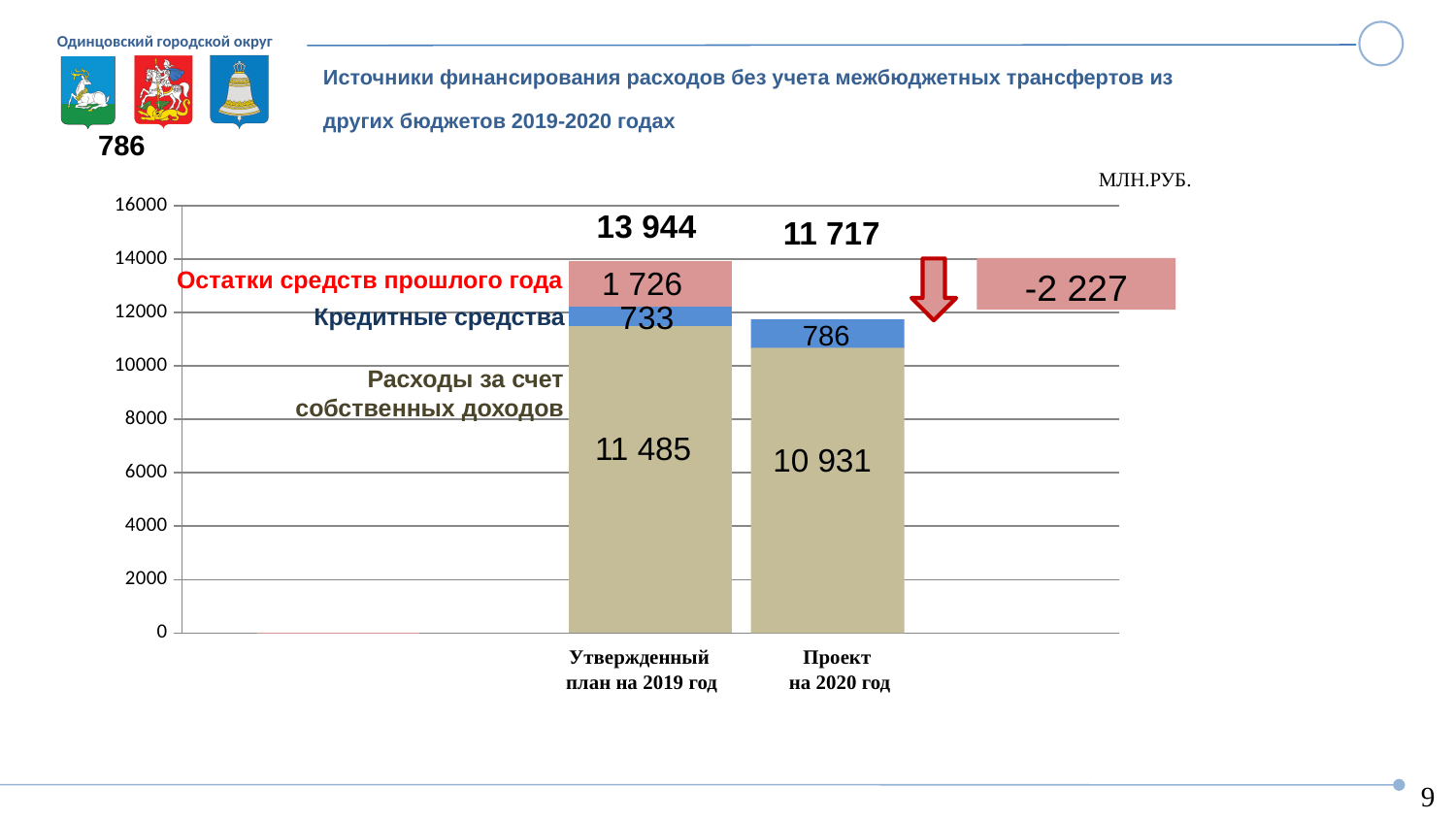
What is the difference between the totals for 'Проект на 2020 год' and 'Утвержденный план на 2019 год' as shown on the slide? -2 227 What is the value of 'Расходы за счет собственных доходов' for 'Проект на 2020 год'? 10 931 How many categories are shown on the x axis of the chart? 2 Which category has the higher total, 'Утвержденный план на 2019 год' or 'Проект на 2020 год'? Утвержденный план на 2019 год In what units are the values on the chart expressed, according to the label above the chart? МЛН.РУБ. What is the value of 'Расходы за счет собственных доходов' for 'Утвержденный план на 2019 год'? 11 485 What is the value of 'Кредитные средства' for 'Проект на 2020 год'? 786 What is the total of the stacked bar for 'Утвержденный план на 2019 год'? 13 944 What is the value of 'Кредитные средства' for 'Утвержденный план на 2019 год'? 733 What is the value of 'Остатки средств прошлого года' for 'Утвержденный план на 2019 год'? 1 726 What kind of chart is shown on the slide? stacked bar chart What is the total of the stacked bar for 'Проект на 2020 год'? 11 717